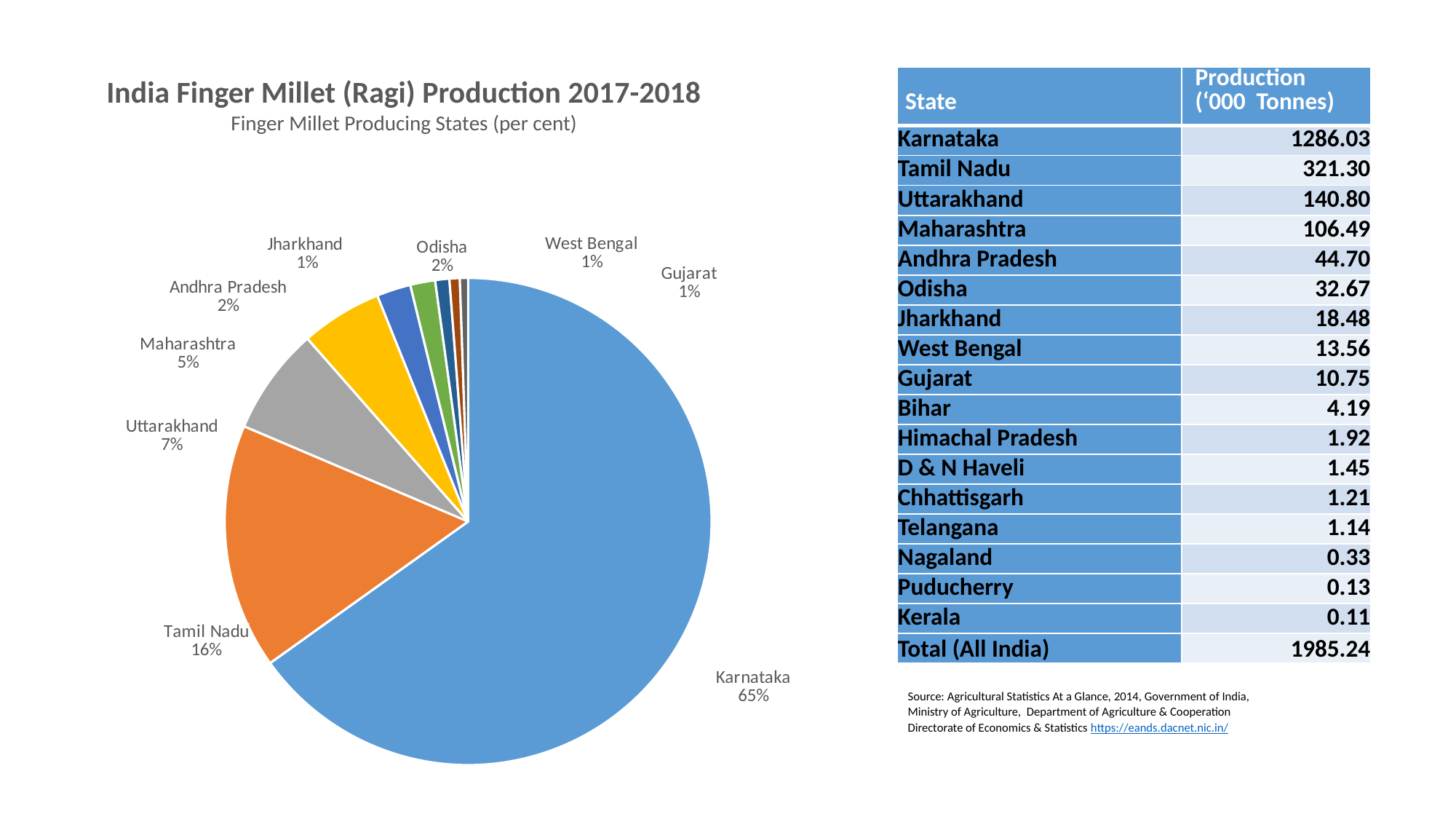
What share of the pie does Tamil Nadu have? 16% What is the title of the chart? India Finger Millet (Ragi) Production 2017-2018 What percentage is shown for Maharashtra in the pie chart? 5% How many percentage points larger is Tamil Nadu's share than Uttarakhand's share in the pie chart? 9 percentage points What percentage is shown for Odisha in the pie chart? 2% What type of chart is shown on the slide? Pie chart What percentage is shown for Uttarakhand in the pie chart? 7% How many labelled slices does the pie chart have? 9 Which has the larger slice in the pie chart, Uttarakhand or Maharashtra? Uttarakhand How many percentage points larger is Karnataka's share than Tamil Nadu's share in the pie chart? 49 percentage points What share of the pie does Karnataka have? 65% Which state has the largest slice of the pie chart? Karnataka